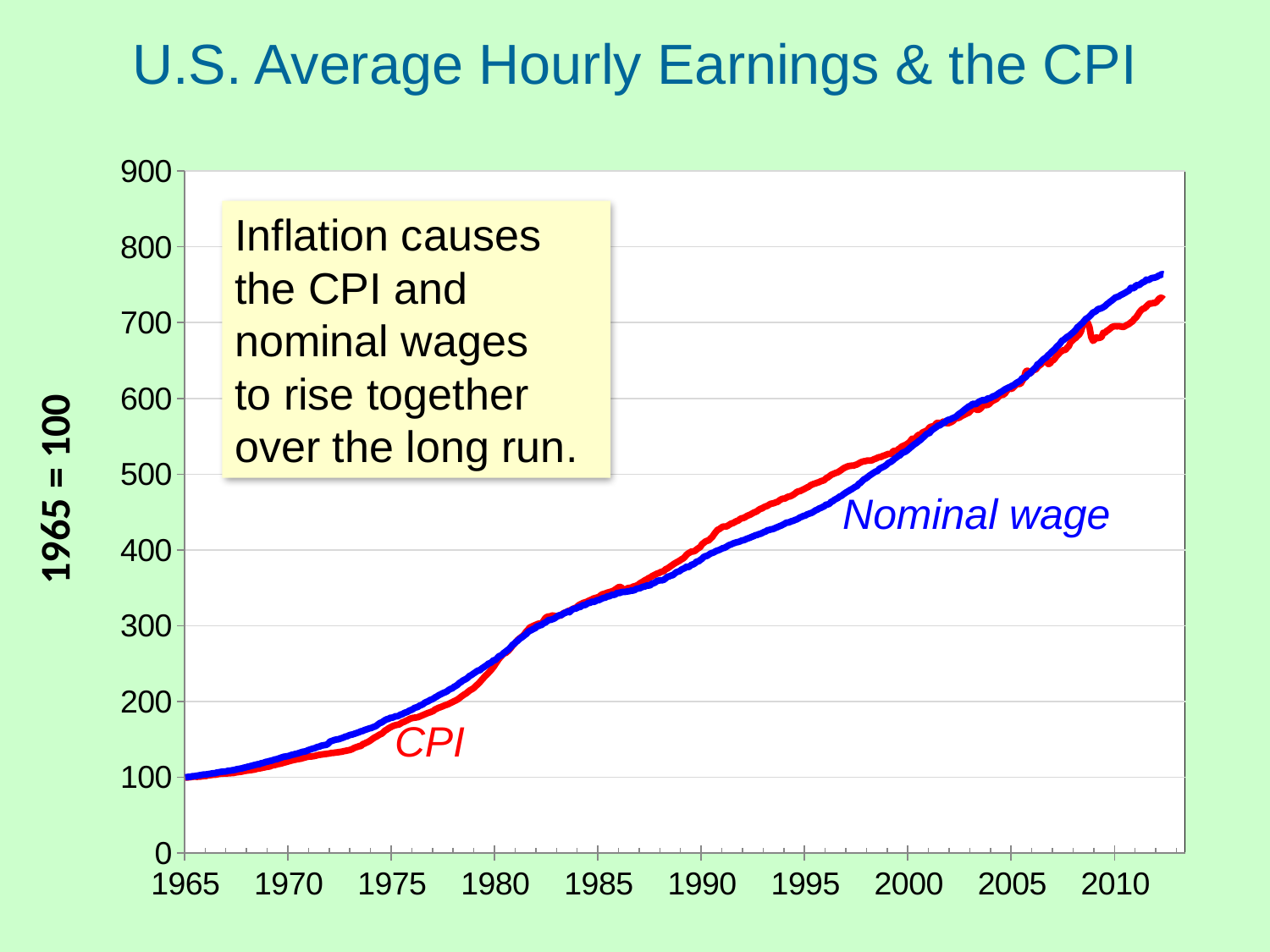
Is the Nominal wage value in 2010 greater or less than 700? greater In 1995, which series is higher, CPI or Nominal wage? CPI Is the CPI value in 1975 greater or less than 200? less What is the value of both series in 1965, the base year? 100 Is the Nominal wage value in 1995 greater or less than 500? less Do the CPI and Nominal wage lines rise or fall from 1965 to 2010? rise What is the title of the chart? U.S. Average Hourly Earnings & the CPI How many data series are plotted on the chart? 2 What kind of chart is shown on the slide? line chart What colour is the CPI line? red Which series reaches the higher value at the right end of the chart? Nominal wage